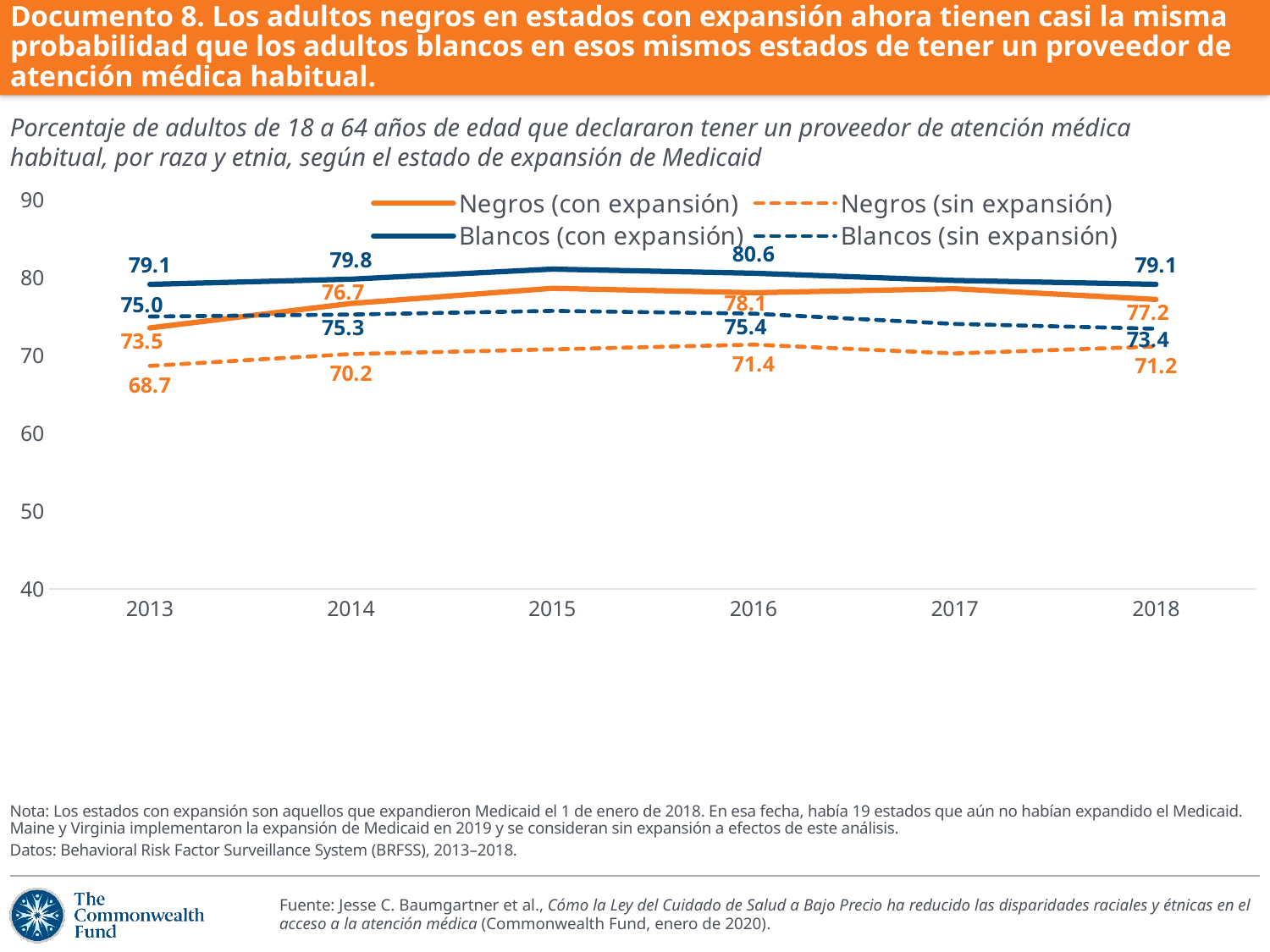
What kind of chart is shown on the slide? Line chart What is the value for Negros (sin expansión) in 2018? 71.2 Is the value for Negros (con expansión) in 2015 greater or less than 70? greater How many series does the legend list? 4 What is the value for Blancos (con expansión) in 2016? 80.6 How many years are shown on the x axis? 6 What is the value for Negros (con expansión) in 2013? 73.5 What is the difference between Negros (con expansión) in 2018 and in 2013? 3.7 What is the difference between Blancos (con expansión) and Negros (con expansión) in 2018? 1.9 What is the value for Blancos (sin expansión) in 2014? 75.3 Which series has the lowest value in 2013? Negros (sin expansión) Which is larger in 2013: Blancos (sin expansión) or Negros (con expansión)? Blancos (sin expansión)